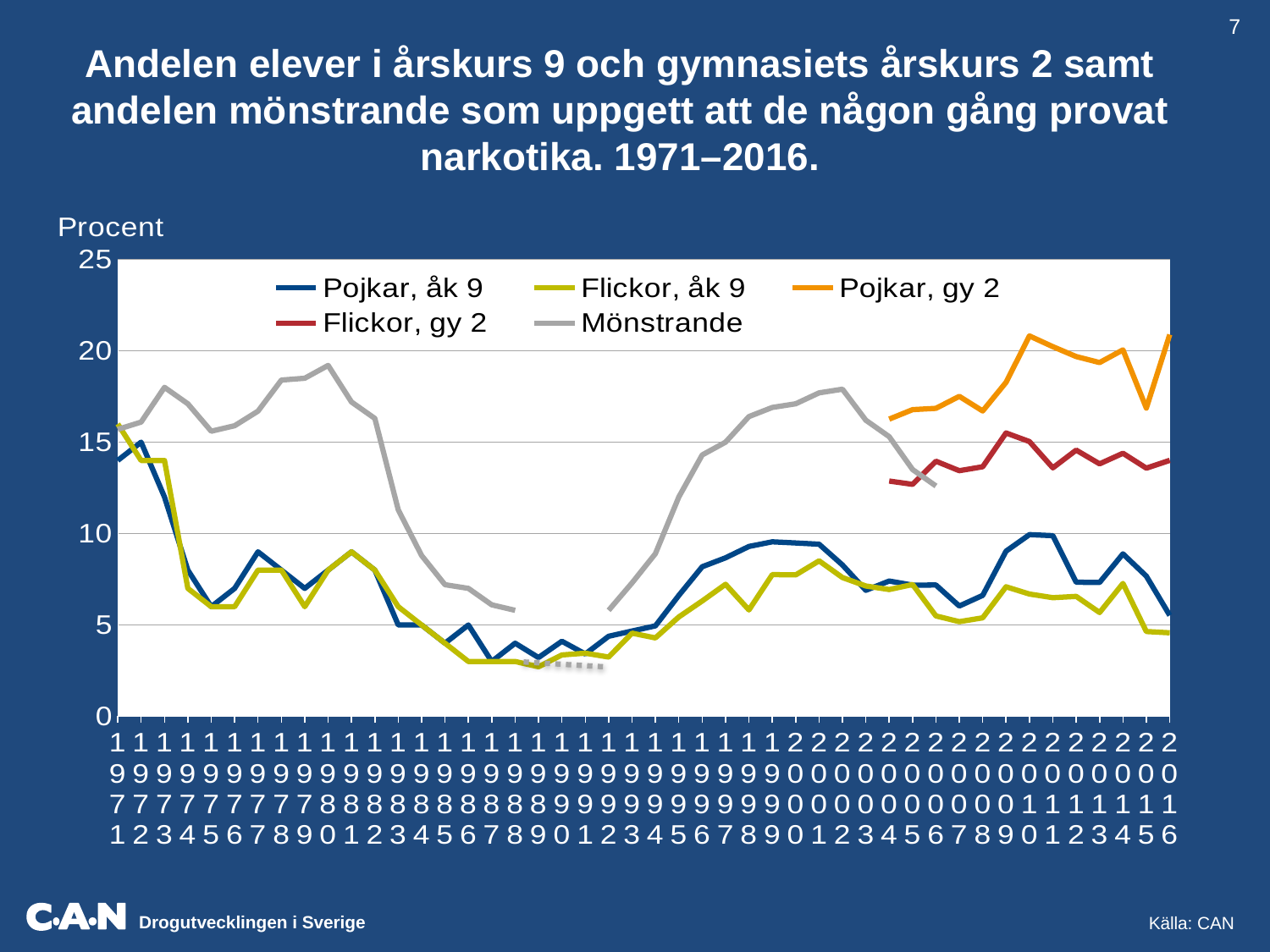
How many series does the legend list? 5 Is the value for Pojkar, gy 2 in 2015 greater or less than 20? less Is the value for Flickor, åk 9 in 2016 greater or less than 5? less Is the value for Flickor, gy 2 in 2004 greater or less than 10? greater In 2016, which is higher: Pojkar, gy 2 or Flickor, gy 2? Pojkar, gy 2 How many years are shown along the x axis (1971–2016)? 46 Which series is drawn in orange? Pojkar, gy 2 Which series has the lowest value in 2016? Flickor, åk 9 What label is shown on the vertical axis of the chart? Procent What kind of chart is shown on the slide? line chart